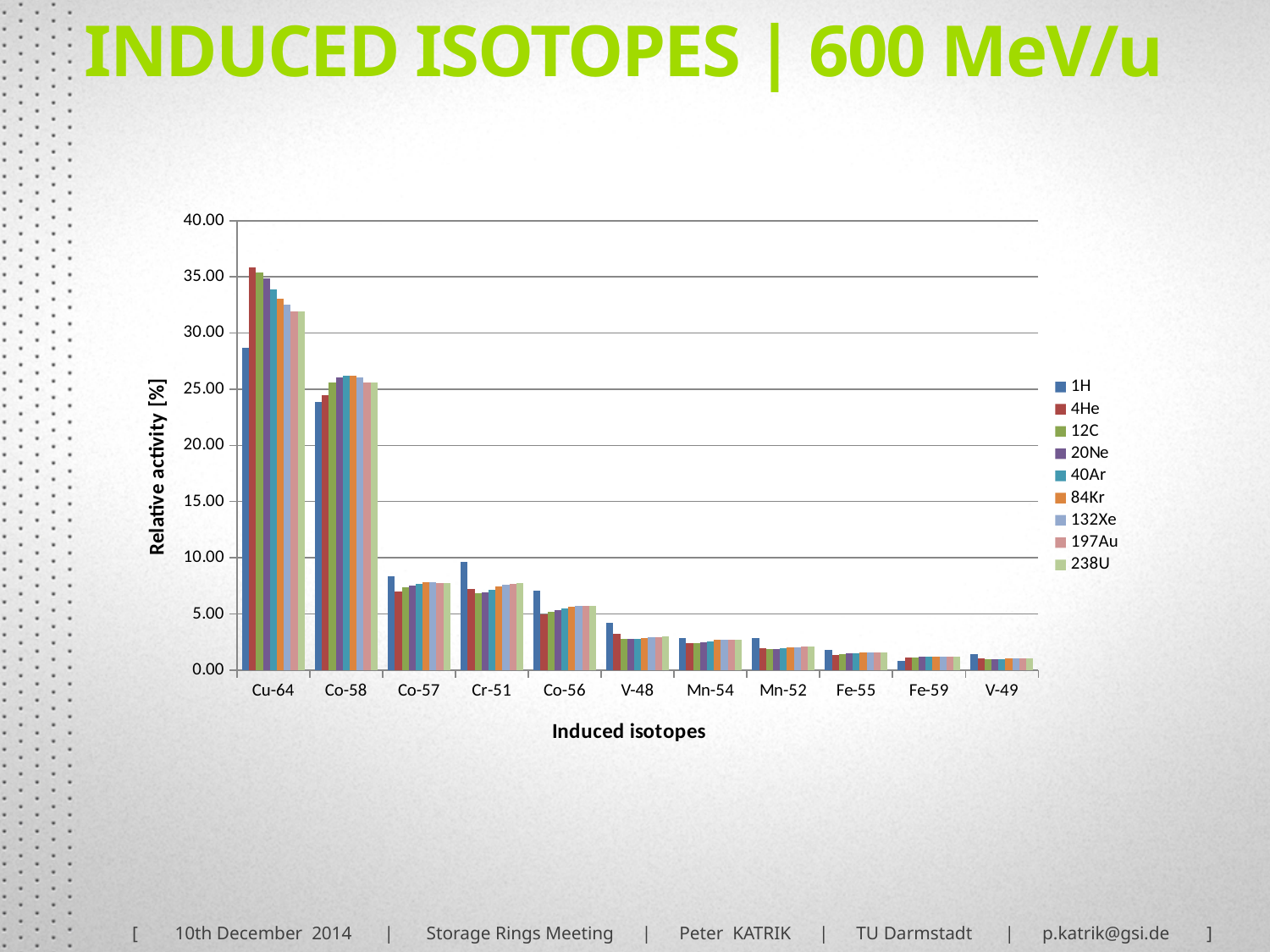
Is the 1H value for Co-56 greater or less than 5.00? greater What kind of chart is shown on the slide? bar chart What is the label of the y axis? Relative activity [%] How many induced isotopes (categories) are shown on the x axis? 11 Is the 1H value for V-48 greater or less than 5.00? less For the 1H series, which is larger: Cu-64 or Co-58? Cu-64 For Cu-64, which series has the lowest relative activity? 1H How many series does the legend list? 9 Is the 1H value for Co-58 greater or less than 25.00? less Which induced isotope has the highest relative activity? Cu-64 Do the relative activity values generally rise or fall from Cu-64 to V-49 along the x axis? fall